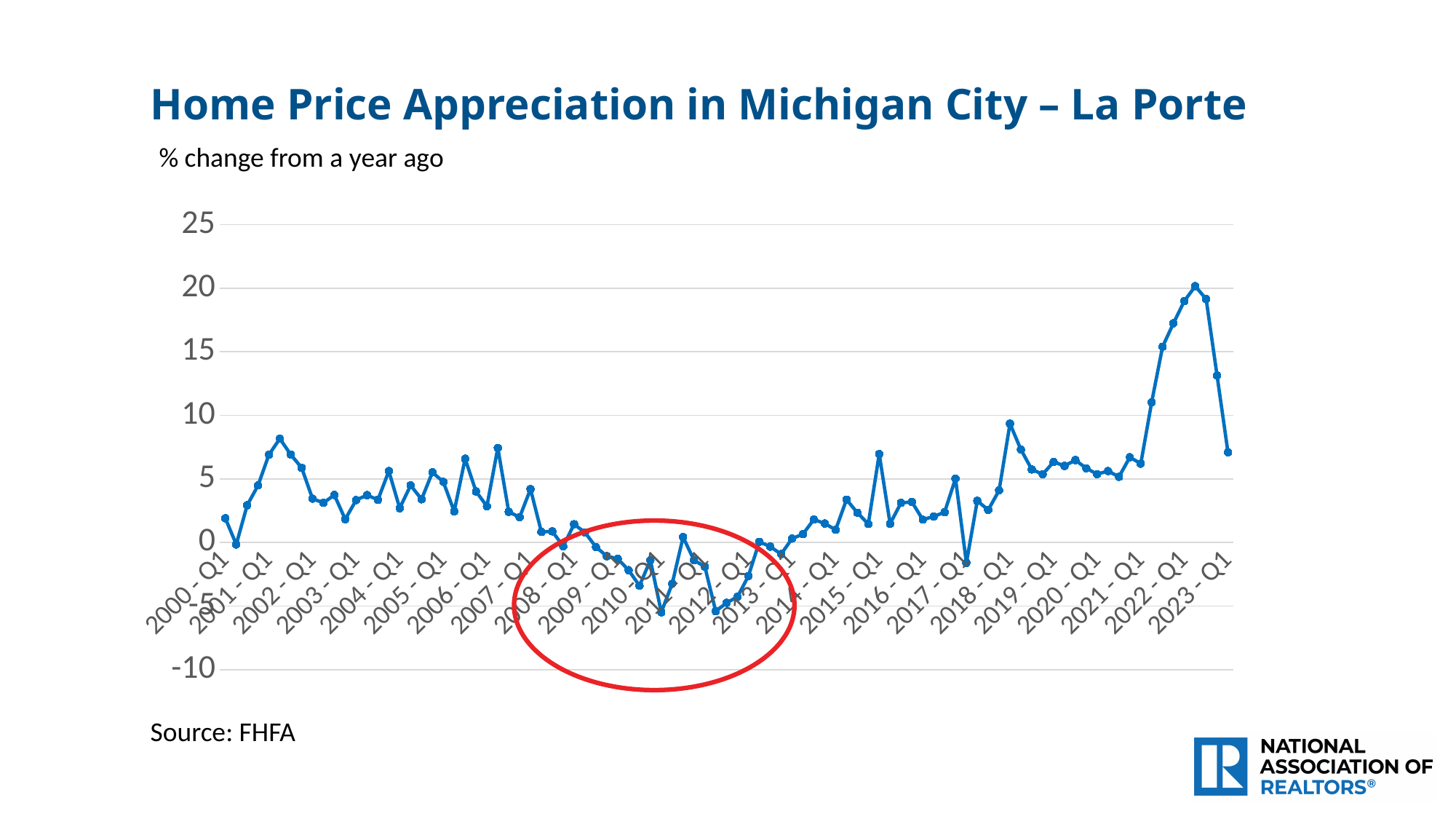
Is the value at 2000 - Q1 greater or less than 5? less What kind of chart is shown on the slide? line chart What unit or measure does the subtitle say the chart plots? % change from a year ago Is the spike near 2018 - Q1 greater or less than 5? greater Is the peak value reached around 2022 greater or less than 15? greater What is the title of the chart? Home Price Appreciation in Michigan City – La Porte Does the line rise or fall between 2021 - Q1 and 2022 - Q1? rise Around which year label does the line reach its highest value? 2022 Does the line rise or fall from its 2022 peak to 2023 - Q1? fall